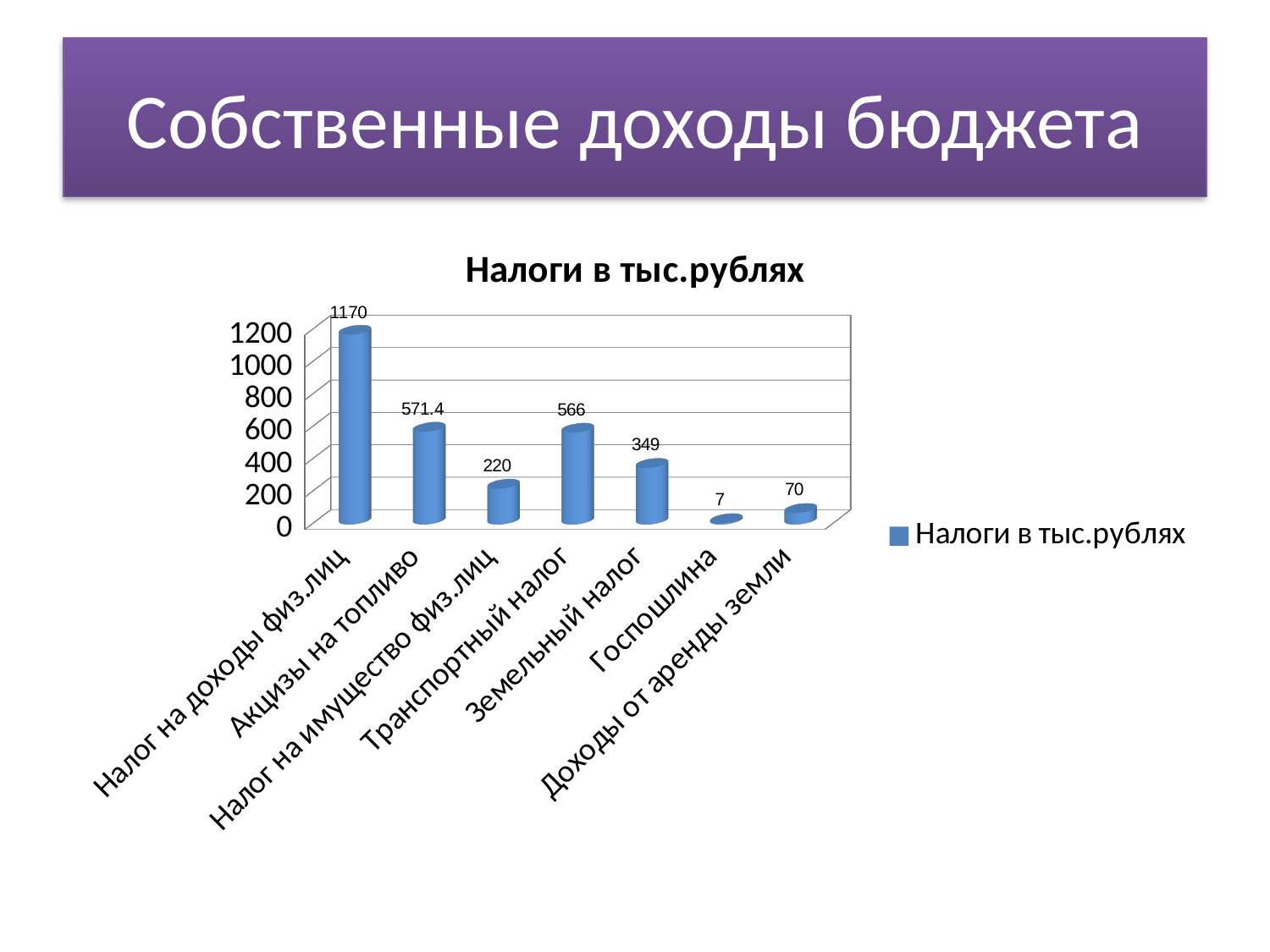
What is the title of the chart? Налоги в тыс.рублях What is the value for Госпошлина? 7 Which category has the highest value? Налог на доходы физ.лиц What is the value for Налог на доходы физ.лиц? 1170 What kind of chart is shown? bar chart Which is larger, Акцизы на топливо or Транспортный налог? Акцизы на топливо Which category has the lowest value? Госпошлина What is the value for Земельный налог? 349 What is the difference between Транспортный налог and Налог на имущество физ.лиц? 346 What is the value for Акцизы на топливо? 571.4 How many series does the legend list? 1 How many categories are shown on the chart? 7